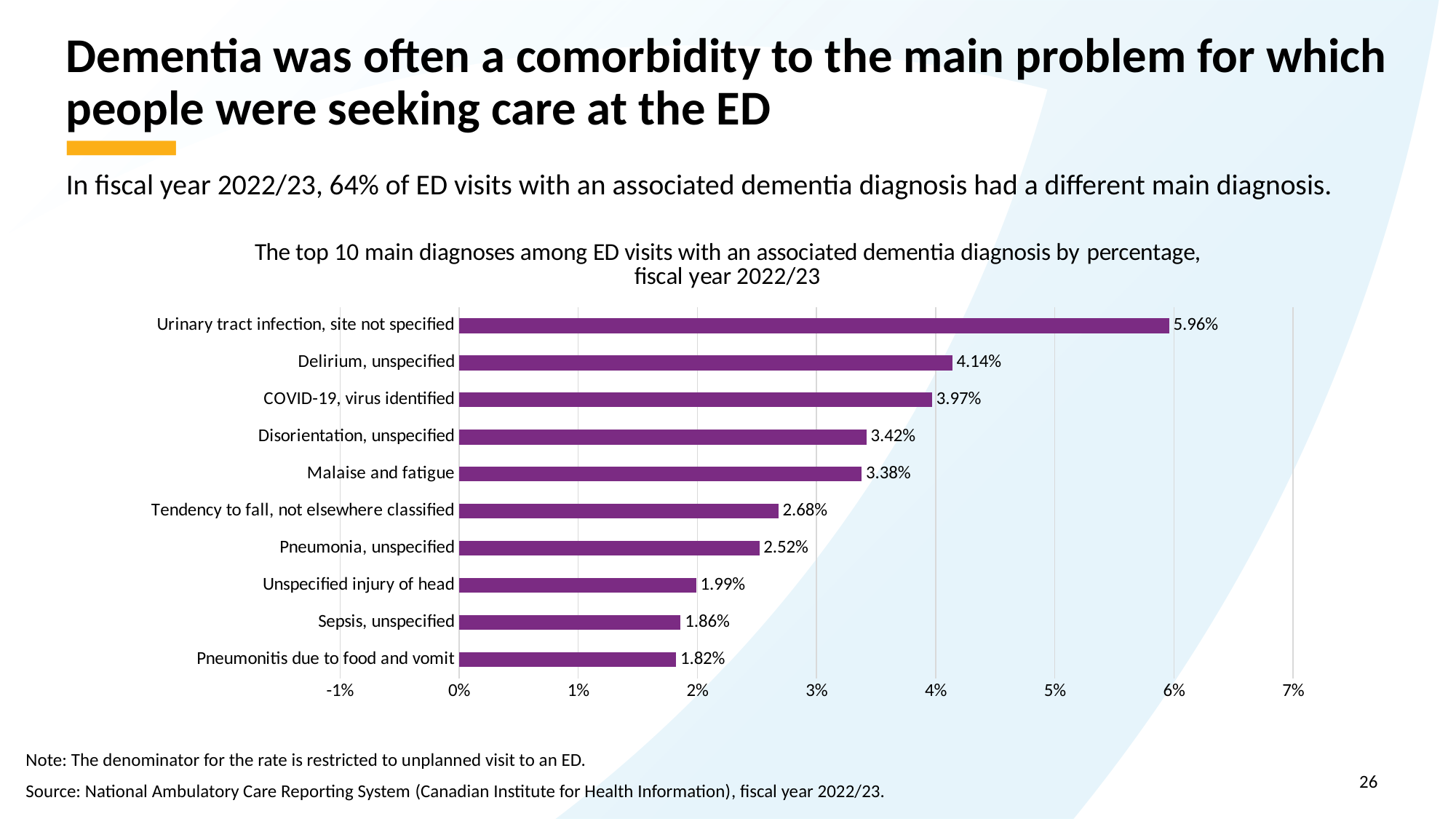
Which main diagnosis has the highest percentage? Urinary tract infection, site not specified What is the value for Tendency to fall, not elsewhere classified? 2.68% Is the value for Pneumonia, unspecified greater or less than 3%? less What fiscal year does the chart title refer to? 2022/23 How many main diagnoses are shown in the chart? 10 Which is larger, the value for COVID-19, virus identified or the value for Disorientation, unspecified? COVID-19, virus identified What kind of chart is shown on the slide? Bar chart What percentage is shown for Urinary tract infection, site not specified? 5.96% What is the difference between the values for Urinary tract infection, site not specified and Delirium, unspecified? 1.82% What is the value for Delirium, unspecified? 4.14% What percentage is shown for Pneumonitis due to food and vomit? 1.82% Which main diagnosis has the lowest percentage? Pneumonitis due to food and vomit